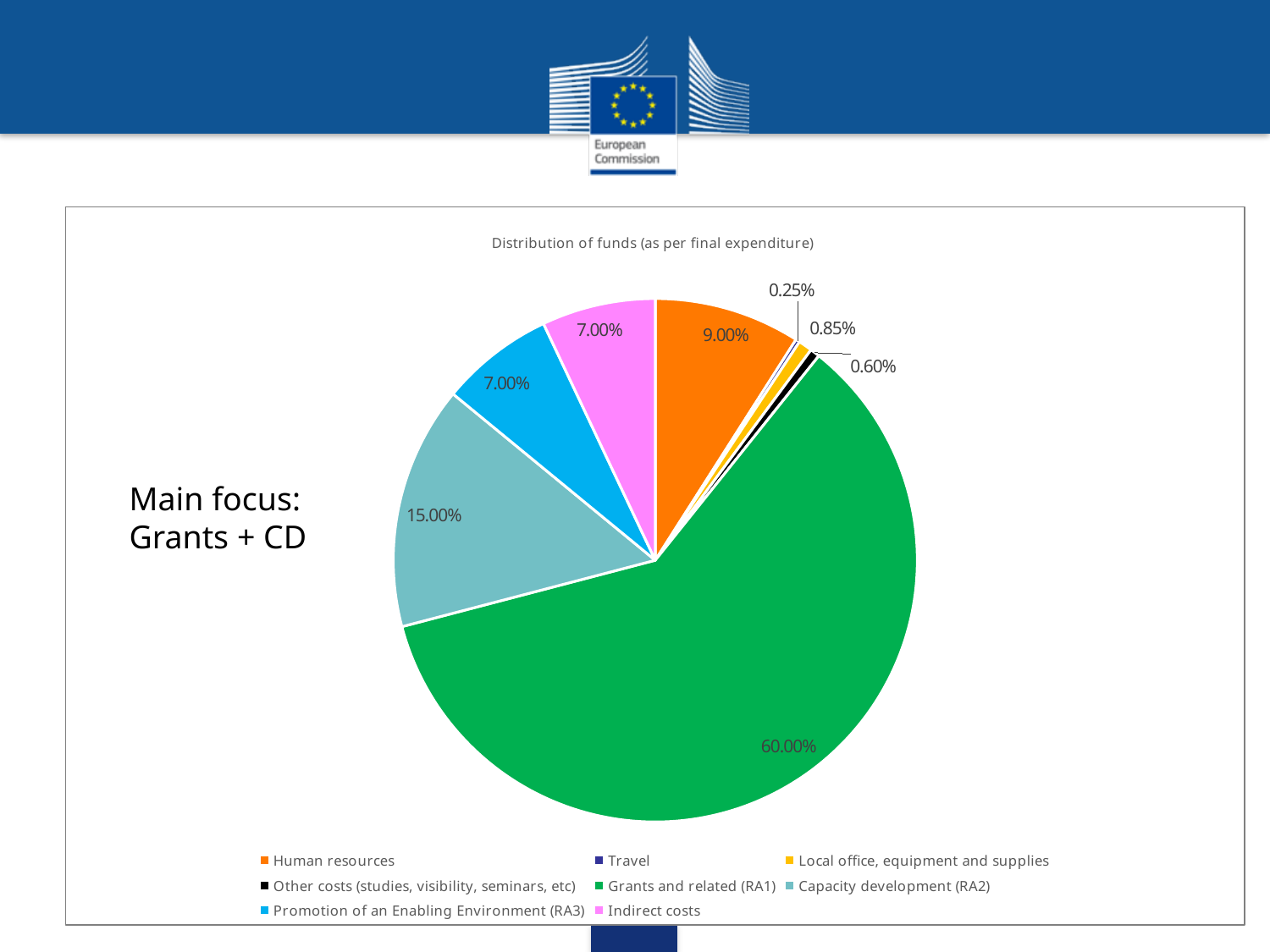
What type of chart is shown on the slide? Pie chart What share of funds goes to Grants and related (RA1)? 60.00% What share of funds goes to Human resources? 9.00% What is the difference between the shares for Grants and related (RA1) and Capacity development (RA2)? 45.00% What is the title of the chart? Distribution of funds (as per final expenditure) Which category has the largest share of funds? Grants and related (RA1) Which category has the smallest share of funds? Travel What share of funds goes to Local office, equipment and supplies? 0.85% How many categories does the legend list? 8 Which is larger, the share for Human resources or the share for Indirect costs? Human resources What share of funds goes to Travel? 0.25% What share of funds goes to Capacity development (RA2)? 15.00%